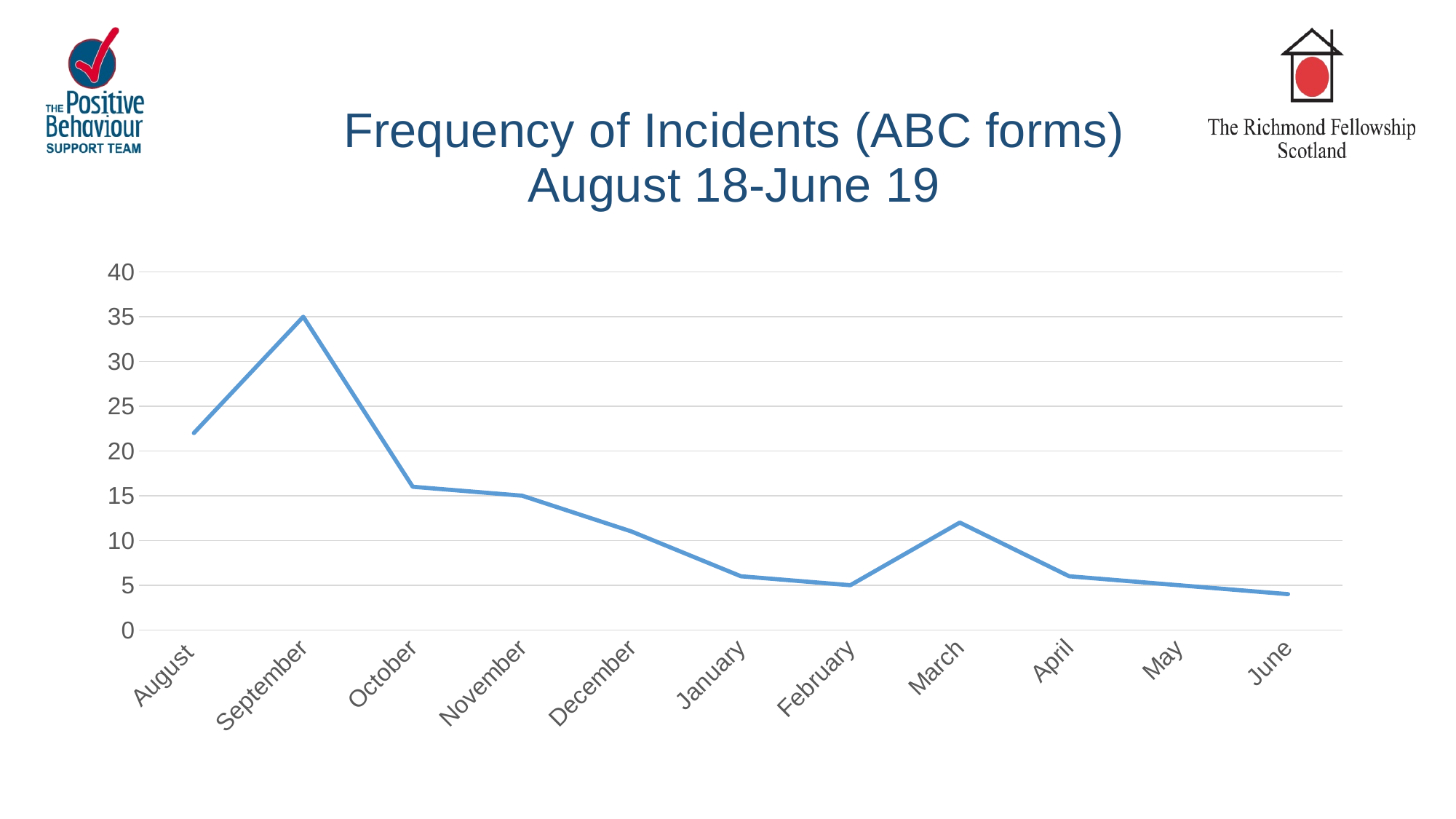
What is the frequency of incidents in September? 35 What is the title of the chart on the slide? Frequency of Incidents (ABC forms) August 18-June 19 Is the value for March greater or less than 10? greater Which month has the larger value, August or October? August Which month has the highest frequency of incidents? September What is the frequency of incidents in November? 15 How many months are plotted along the x axis? 11 Is the value for December greater or less than 15? less Overall, do the values rise or fall from August to June? fall What kind of chart is shown on the slide? line chart Is the value for August greater or less than 20? greater